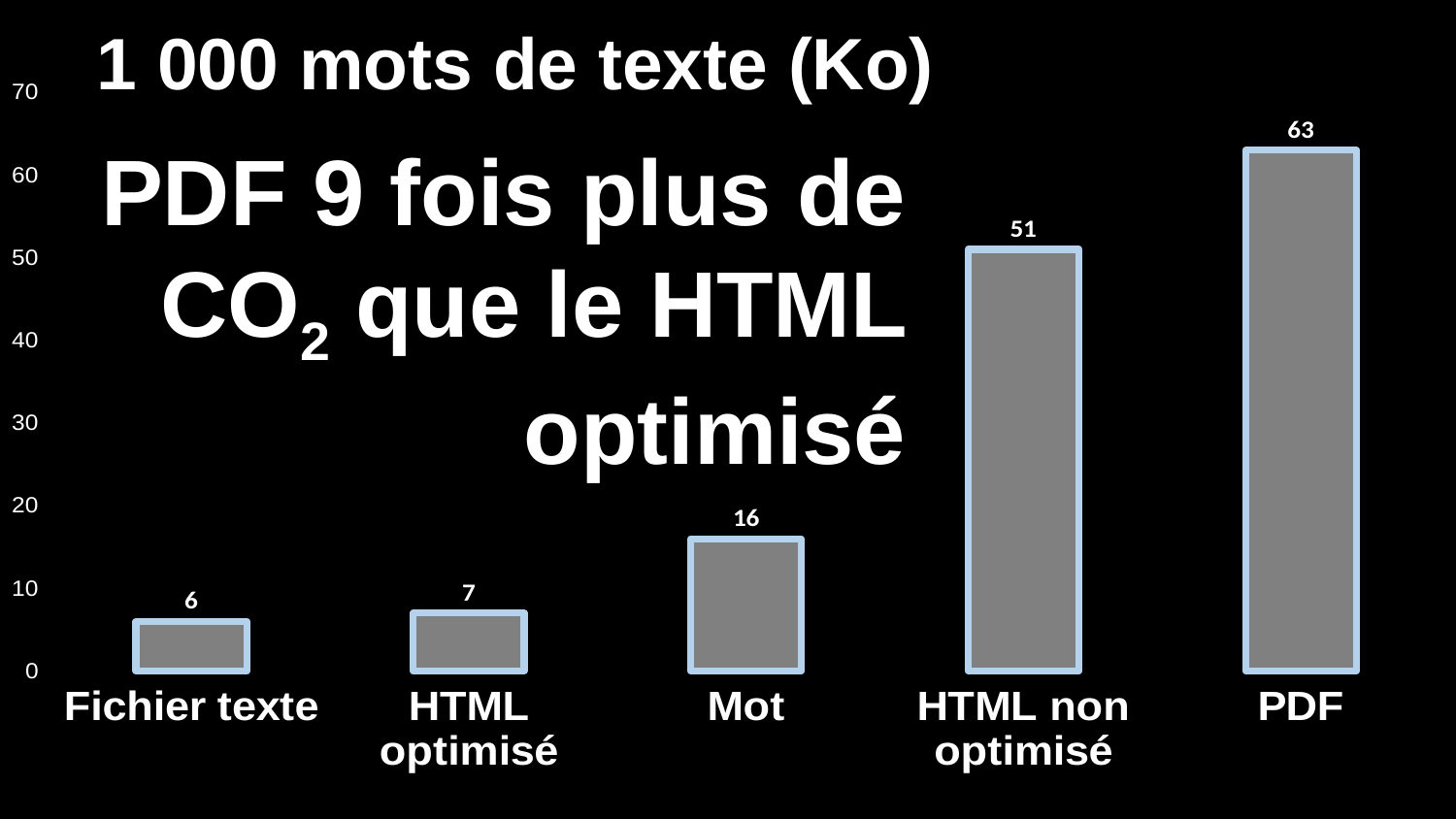
Which category has the lowest value? Fichier texte What is the value for Fichier texte? 6 What is the value for HTML non optimisé? 51 What is the difference between the values for PDF and HTML optimisé? 56 What is the title of the chart? 1 000 mots de texte (Ko) What kind of chart is this? Bar chart Which category has the highest value? PDF What is the difference between the values for HTML non optimisé and Mot? 35 What is the value for PDF? 63 Which is larger, the value for Mot or the value for HTML optimisé? Mot How many categories are shown in the chart? 5 What is the value for Mot? 16